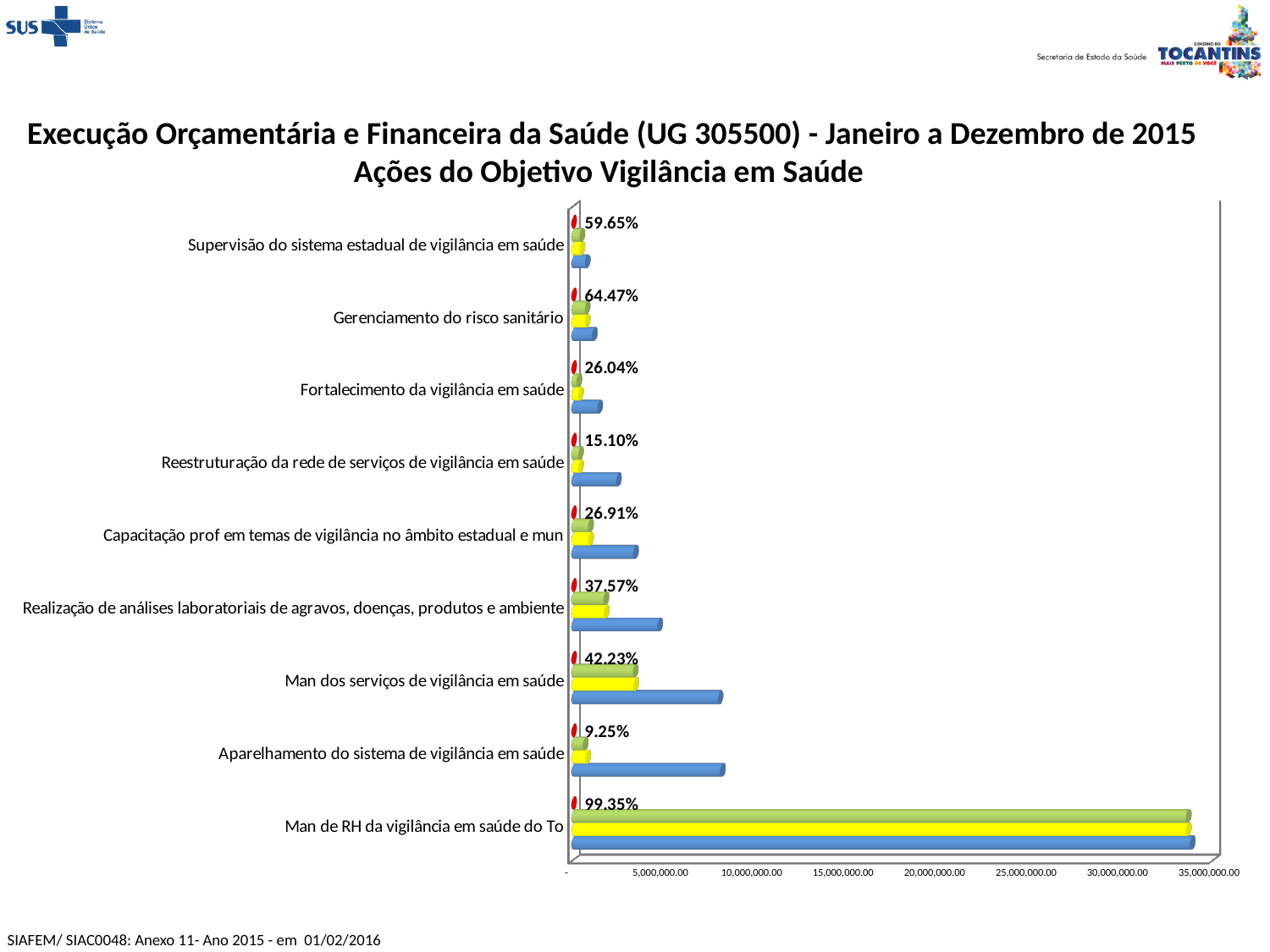
What is the difference in percentage points between "Gerenciamento do risco sanitário" and "Supervisão do sistema estadual de vigilância em saúde"? 4.82 What kind of chart is shown on the slide? Bar chart Which category has the lowest percentage label? Aparelhamento do sistema de vigilância em saúde Which has a higher percentage: "Realização de análises laboratoriais de agravos, doenças, produtos e ambiente" or "Man dos serviços de vigilância em saúde"? Man dos serviços de vigilância em saúde Is the value of the blue bar for "Man dos serviços de vigilância em saúde" greater or less than 10,000,000.00? less What percentage is shown for "Gerenciamento do risco sanitário"? 64.47% What percentage is shown for "Aparelhamento do sistema de vigilância em saúde"? 9.25% What percentage is shown for "Man de RH da vigilância em saúde do To"? 99.35% What percentage is shown for "Reestruturação da rede de serviços de vigilância em saúde"? 15.10% Is the value of the blue bar for "Man de RH da vigilância em saúde do To" greater or less than 30,000,000.00? greater How many categories are shown on the chart? 9 Which category has the highest percentage label? Man de RH da vigilância em saúde do To